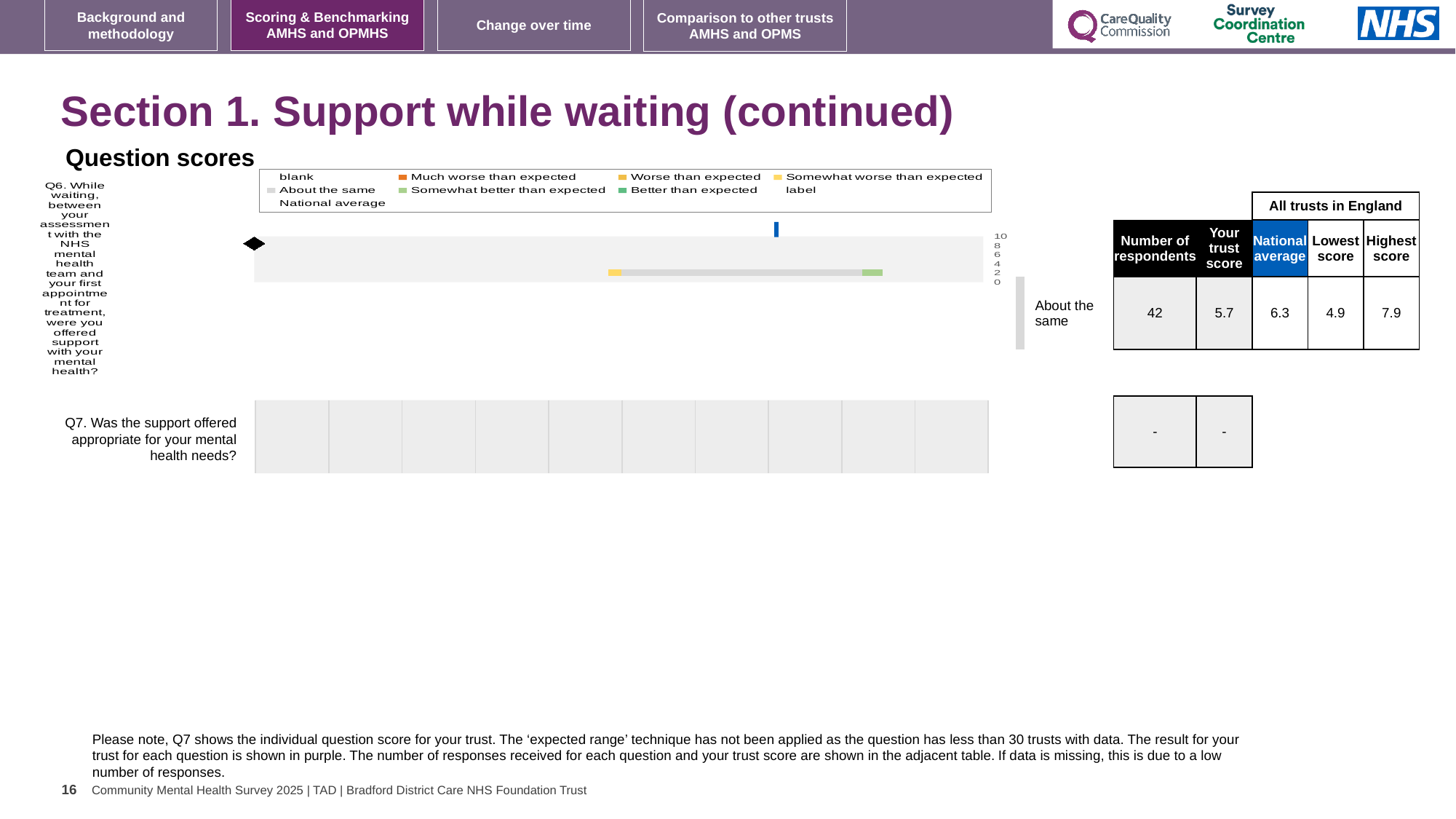
What is the number of respondents for Q6? 42 How many entries does the chart legend list? 9 Which is larger for Q6, the trust score or the national average? national average How many questions are plotted on the chart? 2 What is the difference between the highest and lowest scores for Q6? 3.0 How is the trust's Q6 result categorised relative to the expected range? About the same What is the lowest score among all trusts in England for Q6? 4.9 What is the highest score among all trusts in England for Q6? 7.9 What kind of chart is used to show the Q6 question score? bar chart What is the trust score for Q6? 5.7 What is the difference between the national average and the trust score for Q6? 0.6 What is the national average for Q6? 6.3